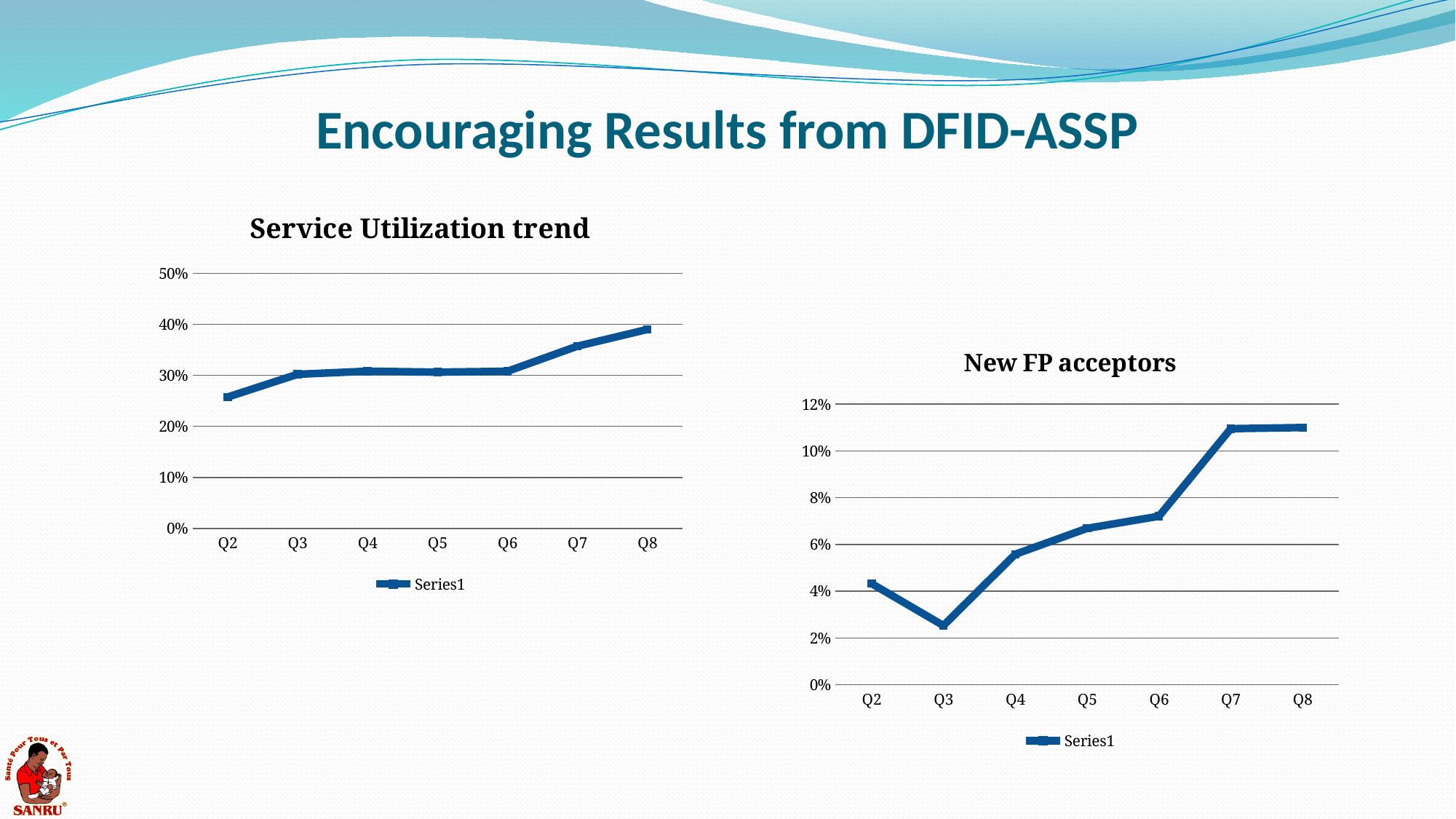
In the "New FP acceptors" chart, which quarter has the lowest value? Q3 In the "Service Utilization trend" chart, which quarter has the lowest value? Q2 In the "Service Utilization trend" chart, which quarter has the highest value? Q8 In the "New FP acceptors" chart, do the values generally rise or fall from Q3 to Q7? rise In the "New FP acceptors" chart, is the value for Q3 greater or less than 4%? less How many quarters are plotted on the x axis of the "Service Utilization trend" chart? 7 In the "Service Utilization trend" chart, is the value for Q7 greater or less than 30%? greater In the "New FP acceptors" chart, which is larger, the value for Q4 or the value for Q3? Q4 How many series does the legend of the "New FP acceptors" chart list? 1 What kind of chart is the "Service Utilization trend" chart? line chart In the "Service Utilization trend" chart, is the value for Q2 greater or less than 30%? less